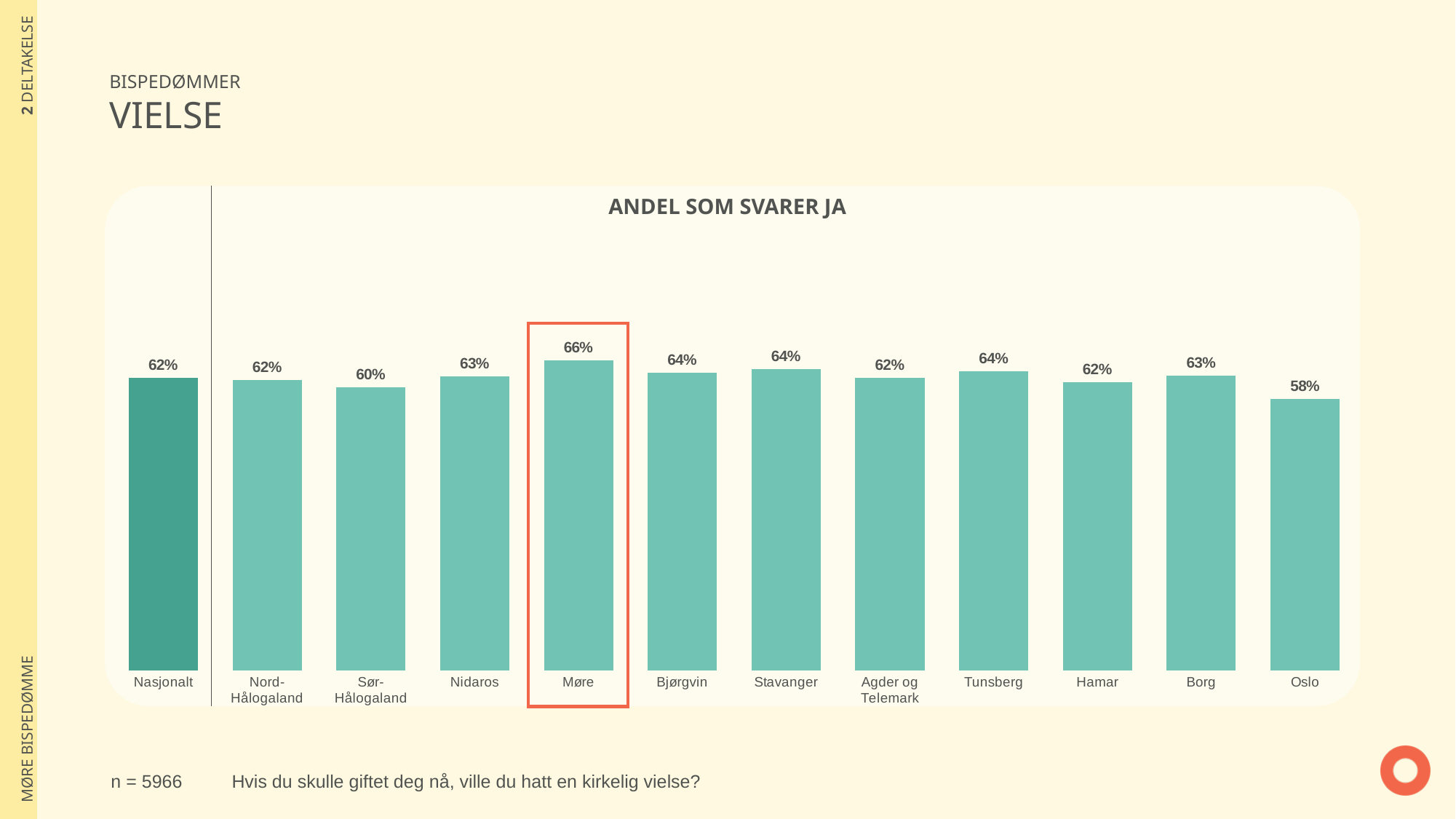
What is the difference between the values for Bjørgvin and Sør-Hålogaland? 4% Which category has the lowest value? Oslo What kind of chart is shown on the slide? Bar chart Which is larger, the value for Nidaros or the value for Oslo? Nidaros Which category has the highest value? Møre What is the difference between the values for Møre and Oslo? 8% How many categories are shown in the chart? 12 What is the value for Sør-Hålogaland? 60% What is the value for Møre? 66% What is the value for Oslo? 58% What is the title of the chart? ANDEL SOM SVARER JA What is the value for Nasjonalt? 62%